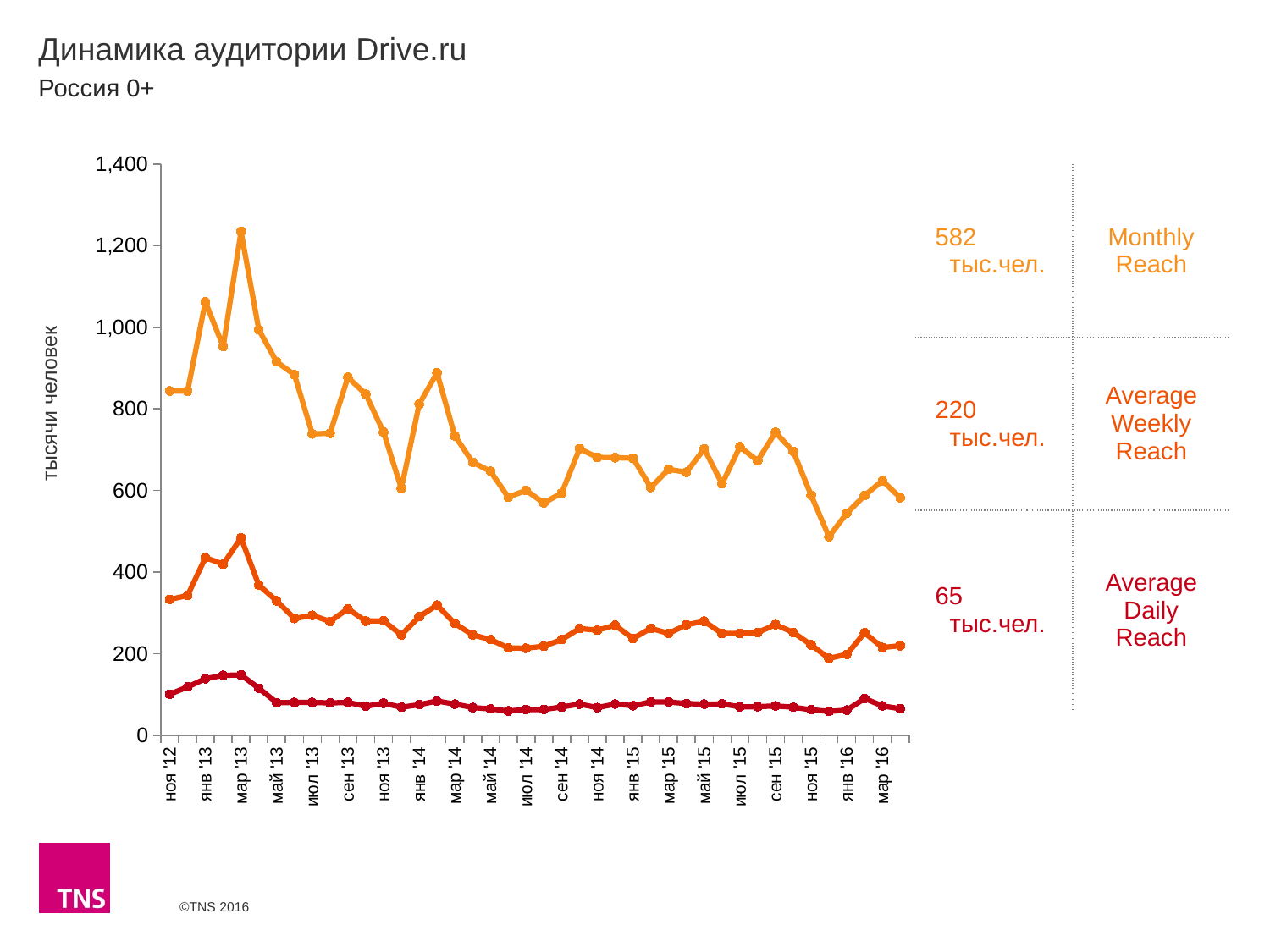
What kind of chart is shown on the slide? line chart Which series has the lowest values throughout the chart? Average Daily Reach What is the label on the vertical axis of the chart? тысячи человек What is the Average Daily Reach value shown in the panel to the right of the chart? 65 тыс.чел. What is the difference between the Monthly Reach (582 тыс.чел.) and the Average Weekly Reach (220 тыс.чел.) shown in the panel? 362 тыс.чел. What is the Average Weekly Reach value shown in the panel to the right of the chart? 220 тыс.чел. Is the Average Daily Reach value at мар '13 greater or less than 200? less Is the Monthly Reach value at мар '13 greater or less than 1,000? greater How many series are plotted on the chart? 3 What is the Monthly Reach value shown in the panel to the right of the chart? 582 тыс.чел. Does the Monthly Reach line overall rise or fall from мар '13 to мар '16? fall Which series has the highest values throughout the chart? Monthly Reach